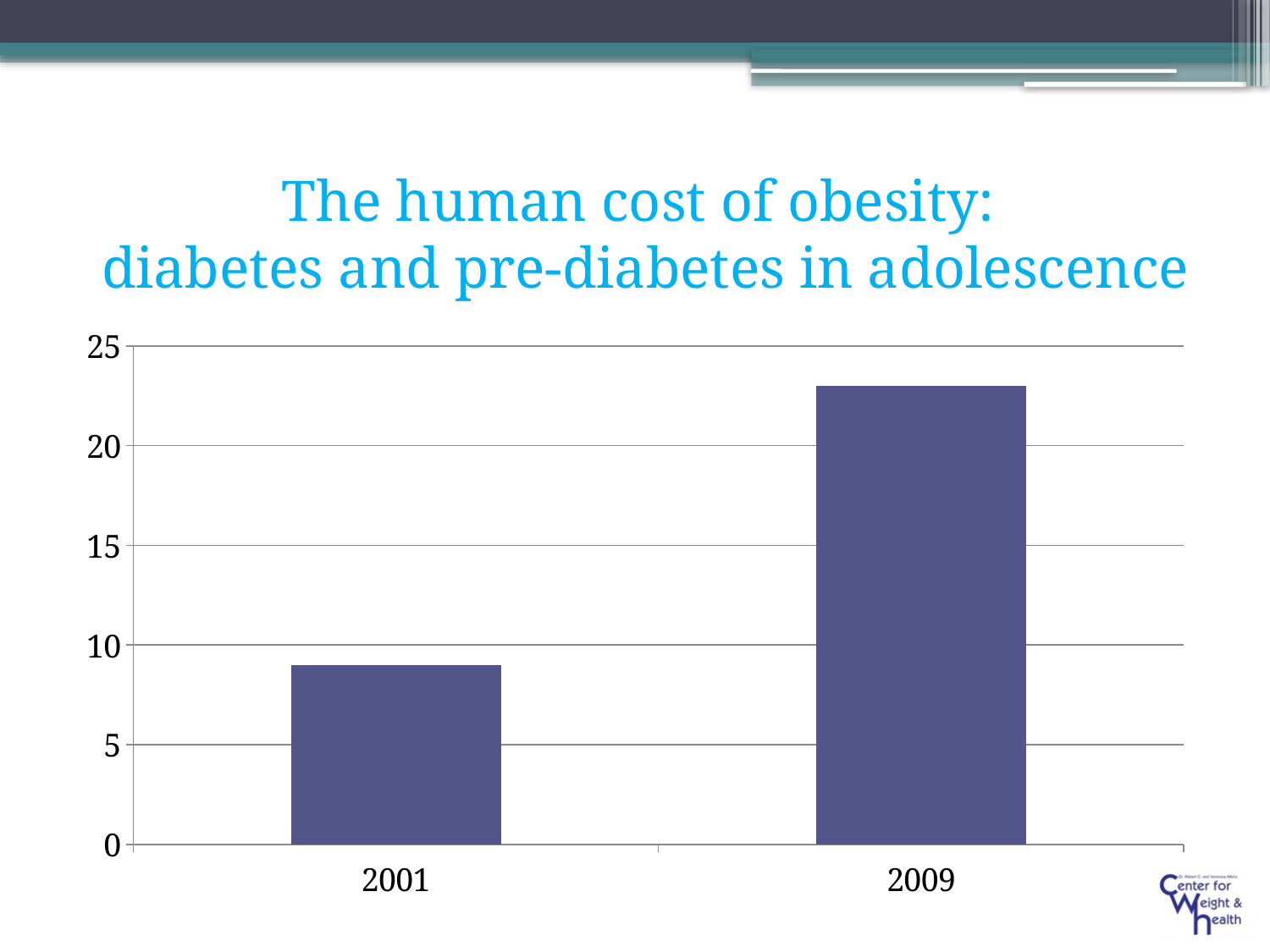
Which is larger, the value for 2001 or the value for 2009? 2009 What is the highest value shown on the y axis? 25 Is the value for 2009 greater or less than 20? greater Which year has the highest bar? 2009 Is the value for 2001 greater or less than 10? less Is the value for 2001 greater or less than 5? greater What is the title of the slide above the chart? The human cost of obesity: diabetes and pre-diabetes in adolescence Which year has the lowest bar? 2001 What kind of chart is shown on the slide? bar chart Do the values rise or fall from 2001 to 2009? rise How many categories are plotted on the x axis? 2